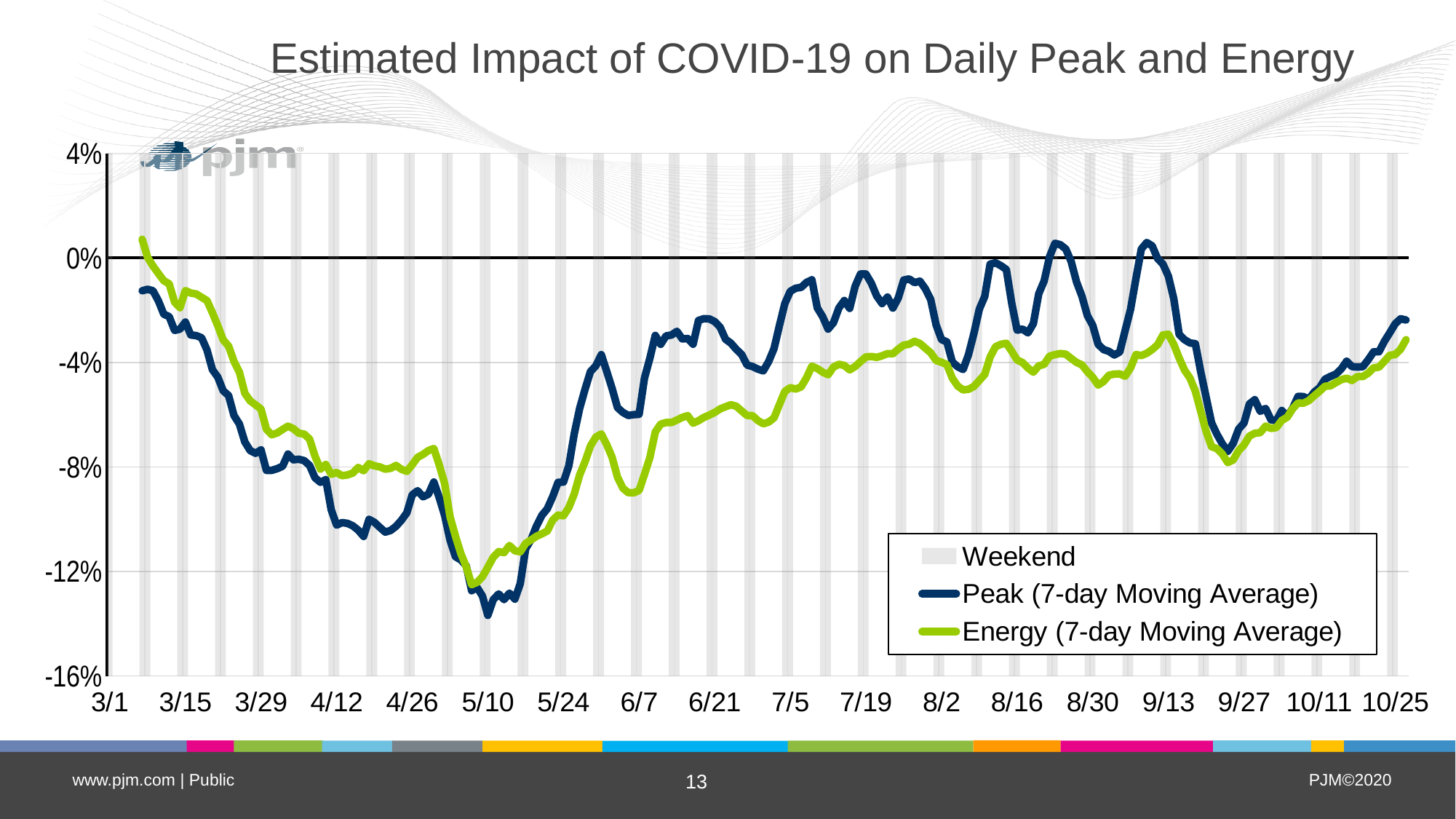
Is the value of Peak (7-day Moving Average) around 5/10 greater or less than -12%? less Between 3/1 and 5/10, do the Peak and Energy lines generally rise or fall? fall How many entries does the chart legend list? 3 What is the title of the chart? Estimated Impact of COVID-19 on Daily Peak and Energy Around 4/12, which line is lower: Peak (7-day Moving Average) or Energy (7-day Moving Average)? Peak (7-day Moving Average) Which series reaches the lowest value anywhere on the chart? Peak (7-day Moving Average) Is the value of Energy (7-day Moving Average) around 6/7 greater or less than -8%? less Is the value of Peak (7-day Moving Average) around 9/27 greater or less than -4%? less What kind of chart is shown on the slide? Line chart Around 7/19, which line is higher: Peak (7-day Moving Average) or Energy (7-day Moving Average)? Peak (7-day Moving Average) What do the grey vertical bands in the chart represent, according to the legend? Weekend